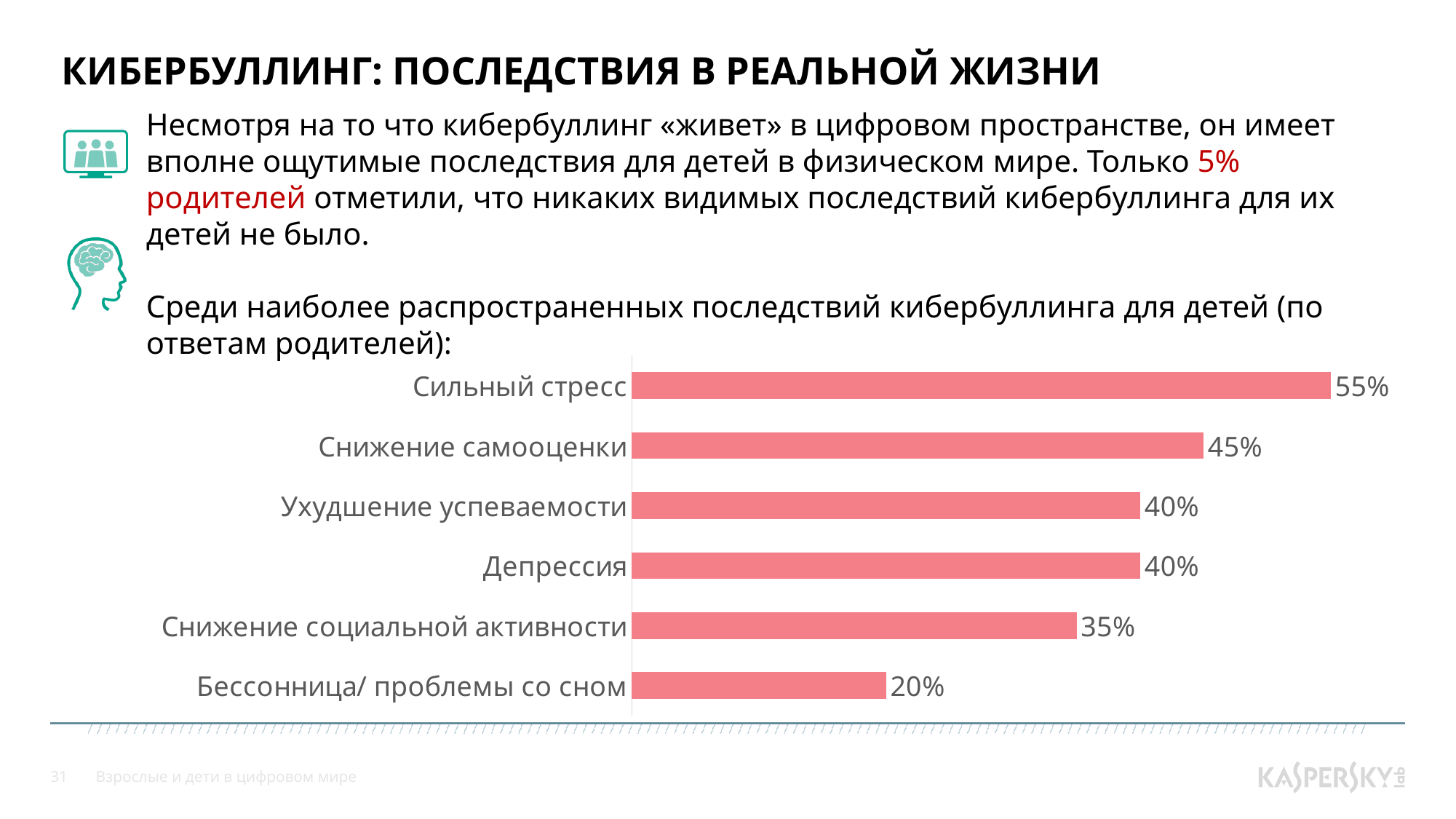
What is the value for «Сильный стресс»? 55% How many categories are shown in the chart? 6 What is the value for «Снижение самооценки»? 45% What is the value for «Бессонница/ проблемы со сном»? 20% What is the difference between the values for «Сильный стресс» and «Снижение самооценки»? 10% Which two categories share the same value of 40%? Ухудшение успеваемости and Депрессия Which category has the highest value? Сильный стресс What is the value for «Снижение социальной активности»? 35% Which category has the lowest value? Бессонница/ проблемы со сном What is the difference between the values for «Снижение социальной активности» and «Бессонница/ проблемы со сном»? 15% Which is larger: the value for «Снижение самооценки» or the value for «Депрессия»? Снижение самооценки What kind of chart is shown on the slide? Bar chart